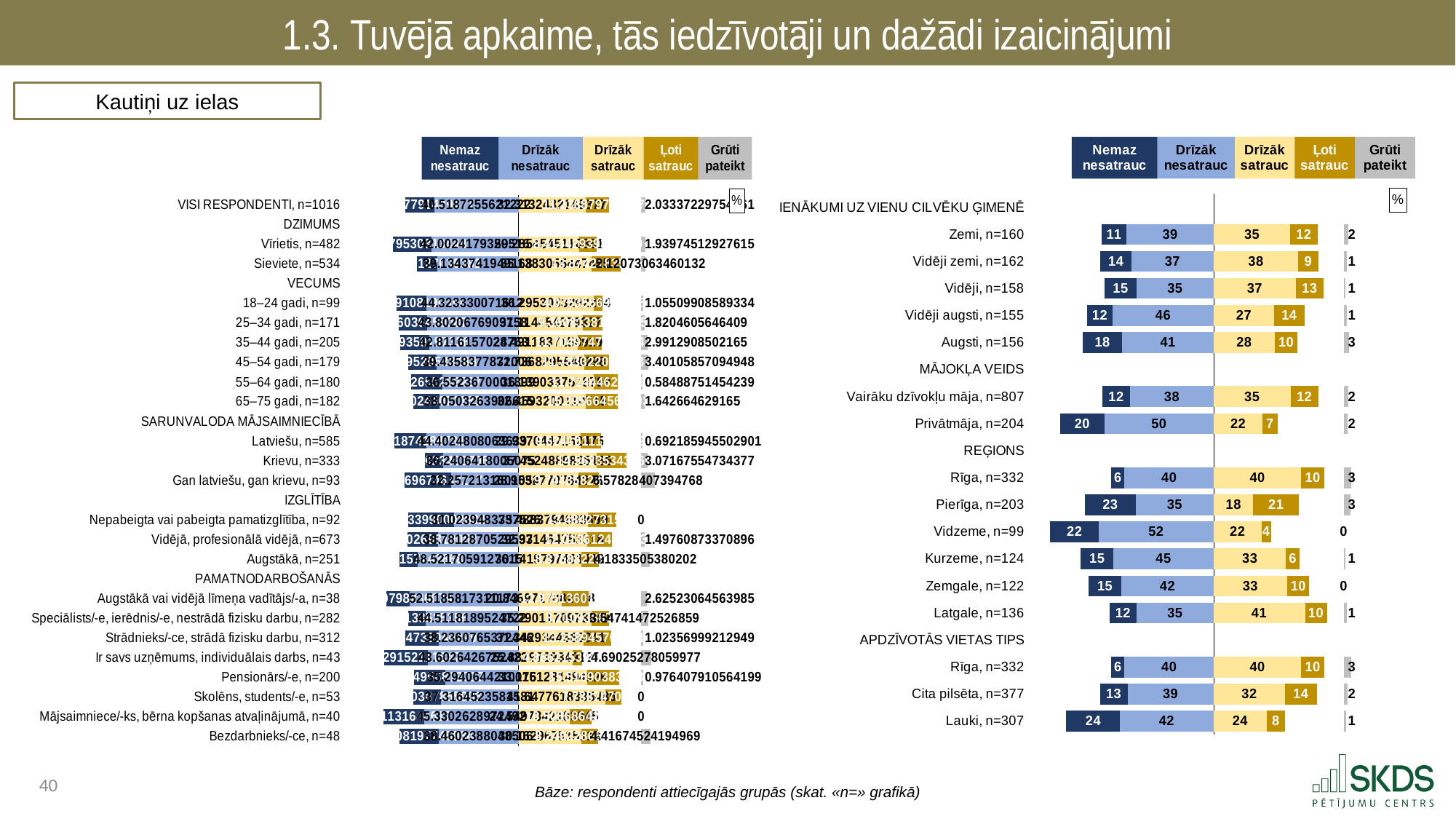
In the chart on the right side of the slide, what is the value for "Drīzāk nesatrauc" for Privātmāja, n=204? 50 In the chart on the right side of the slide, what is the total of the "Nemaz nesatrauc" and "Drīzāk nesatrauc" values for Vidzeme, n=99? 74 In the chart on the right side of the slide, what is the difference between the "Drīzāk nesatrauc" values for Vidēji augsti, n=155 and Vidēji, n=158? 11 How many series does the legend of the chart on the right side of the slide list? 5 In the chart on the right side of the slide, what is the value for "Nemaz nesatrauc" for Lauki, n=307? 24 In the chart on the right side of the slide, which is larger: the "Ļoti satrauc" value for Cita pilsēta, n=377 or for Lauki, n=307? Cita pilsēta, n=377 In the chart on the right side of the slide, what is the value for "Ļoti satrauc" for Pierīga, n=203? 21 In the chart on the right side of the slide, which region has the highest "Drīzāk nesatrauc" value? Vidzeme, n=99 What kind of chart is shown on the right side of the slide? Stacked bar chart In the chart on the right side of the slide, what is the "Grūti pateikt" value for Zemgale, n=122? 0 In the chart on the right side of the slide, which income group has the lowest "Nemaz nesatrauc" value? Zemi, n=160 In the chart on the right side of the slide, what is the value for "Drīzāk satrauc" for Latgale, n=136? 41